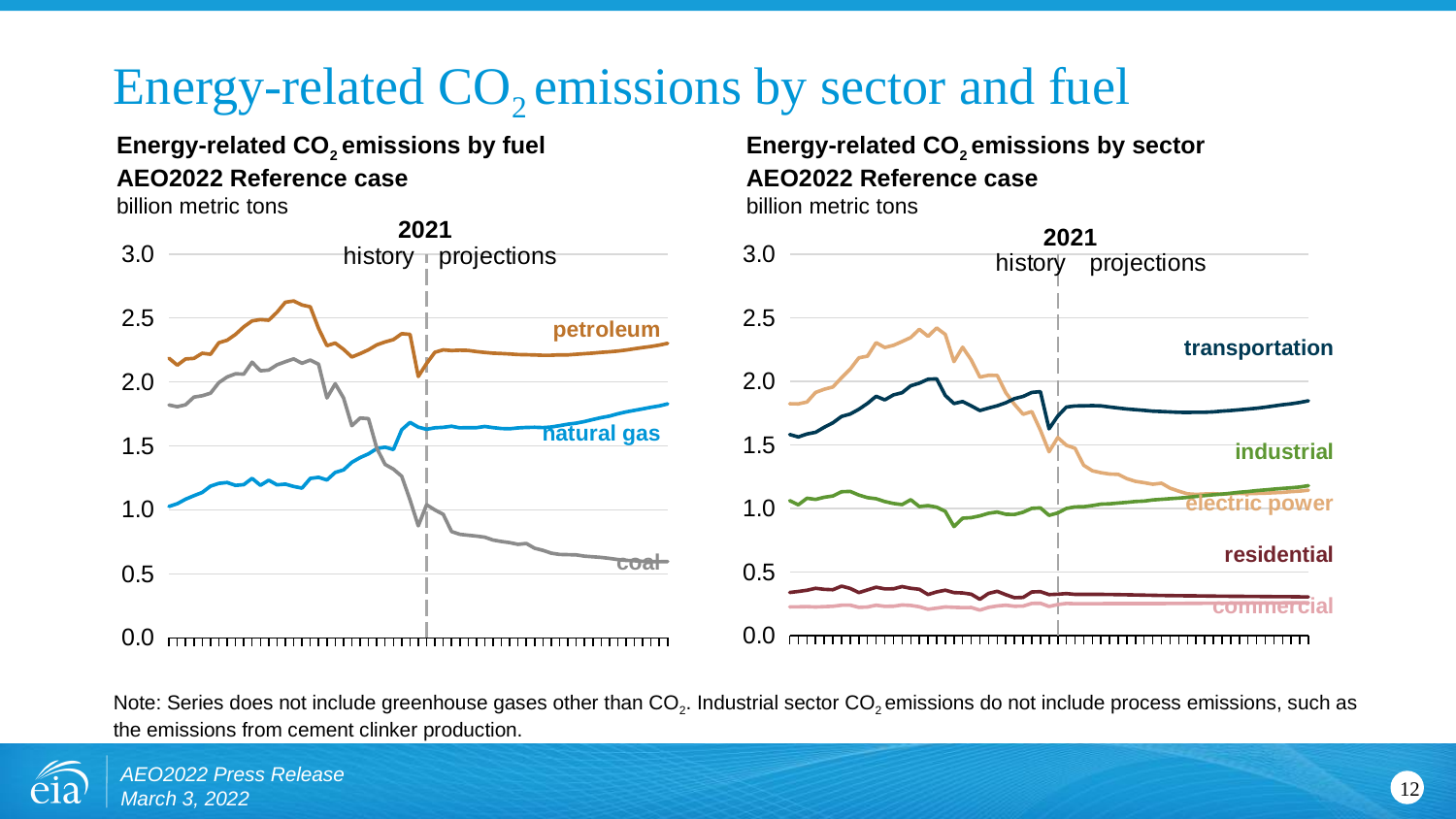
What type of chart is the 'Energy-related CO2 emissions by fuel' chart on the left? line chart In the left chart (emissions by fuel), is the value for coal at the end of the projection period greater or less than 1.0? less In the right chart (emissions by sector), which sector has the highest emissions at the end of the projection period? transportation In the left chart (emissions by fuel), which fuel has the lowest emissions at the end of the projection period? coal How many sector series are plotted in the right chart, 'Energy-related CO2 emissions by sector'? 5 How many fuel series are plotted in the left chart, 'Energy-related CO2 emissions by fuel'? 3 In the right chart (emissions by sector), is the value for electric power at the end of the projection period greater or less than 1.5? less What unit of measurement is shown for both charts? billion metric tons In the right chart (emissions by sector), does the electric power series rise or fall over the period shown? fall In the right chart (emissions by sector), which sector has the lowest emissions at the end of the projection period? commercial In the left chart (emissions by fuel), which fuel has the highest emissions at the end of the projection period? petroleum In the left chart (emissions by fuel), does the coal series rise or fall over the period shown? fall